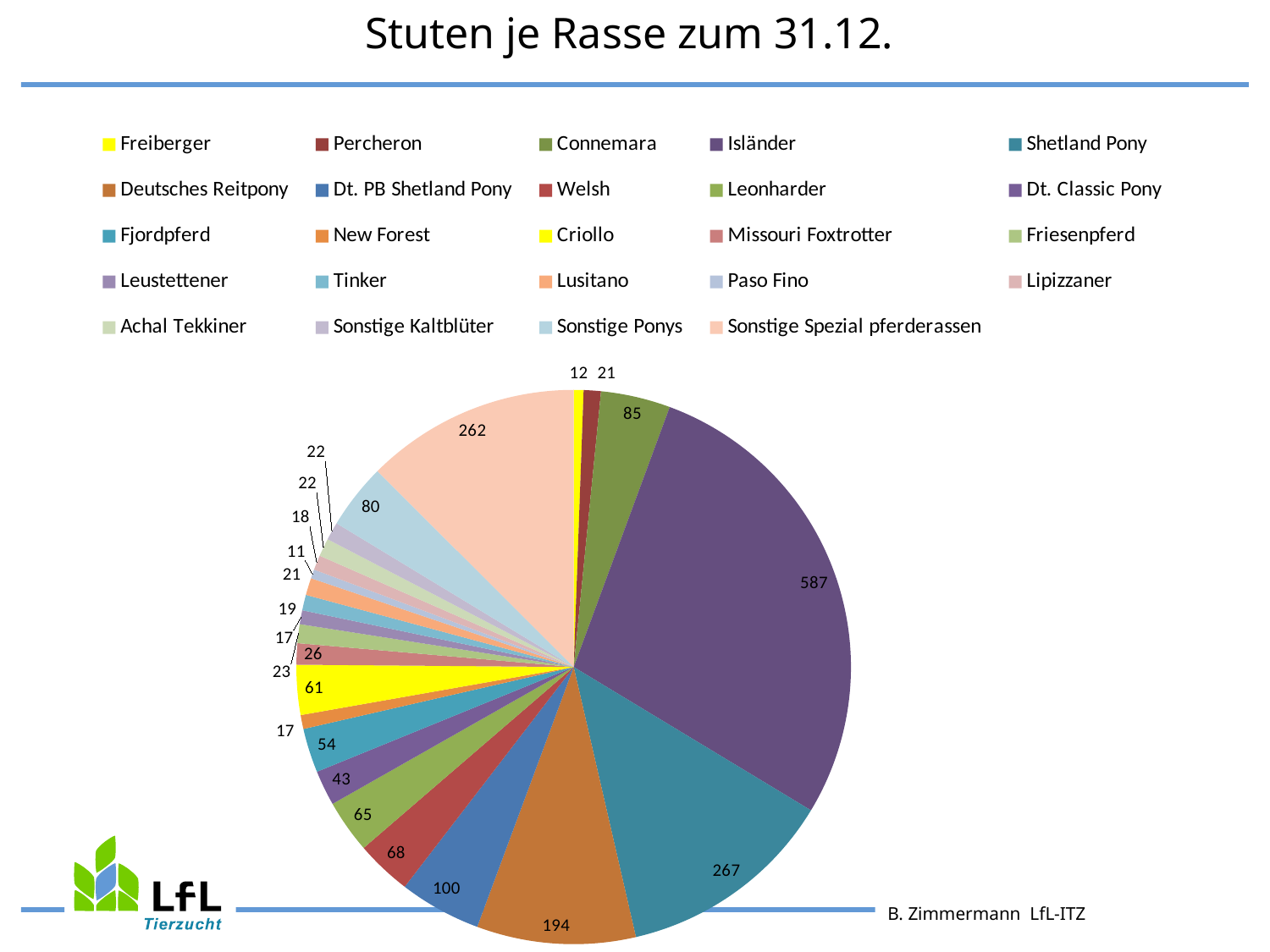
What is the value for Criollo? 61 What is the value for Sonstige Ponys? 80 What is the difference between the values for Shetland Pony and Deutsches Reitpony? 73 What share of the total does the Isländer slice represent, to the nearest percent? 28% What is the title of the chart? Stuten je Rasse zum 31.12. What is the value for Isländer? 587 Which is larger, the value for Connemara or the value for Welsh? Connemara Which breed has the largest slice of the pie? Isländer Which breed has the smallest slice of the pie? Paso Fino What is the value for Shetland Pony? 267 What type of chart is shown on the slide? pie chart How many breeds (slices) does the pie chart show? 24